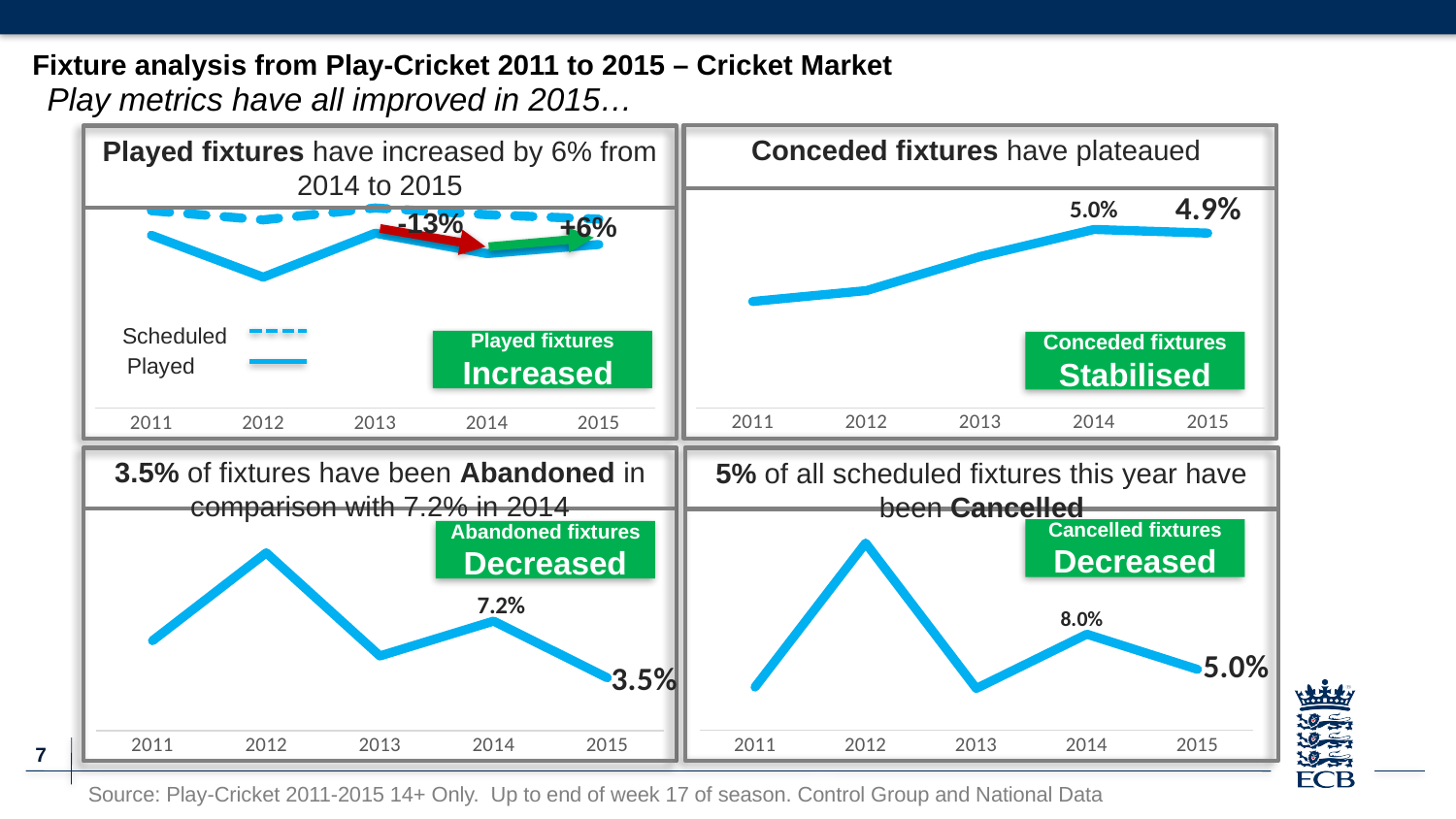
In the Abandoned fixtures chart (bottom left), which year has the highest value? 2012 How many years are shown on the x axis of the Abandoned fixtures chart (bottom left)? 5 In the Cancelled fixtures chart (bottom right), which year has the highest value? 2012 In the Conceded fixtures chart (top right), what is the value for 2014? 5.0% In the Conceded fixtures chart (top right), what is the value for 2015? 4.9% What kind of chart is the Conceded fixtures chart (top right)? Line chart How many series does the legend of the Played fixtures chart (top left) list? 2 In the Abandoned fixtures chart (bottom left), what is the difference between the 2014 and 2015 values? 3.7 percentage points In the Cancelled fixtures chart (bottom right), which is larger, the value for 2014 or the value for 2015? 2014 In the Cancelled fixtures chart (bottom right), what is the value for 2015? 5.0% In the Abandoned fixtures chart (bottom left), what is the value for 2014? 7.2% In the Cancelled fixtures chart (bottom right), what is the difference between the 2014 and 2015 values? 3.0 percentage points